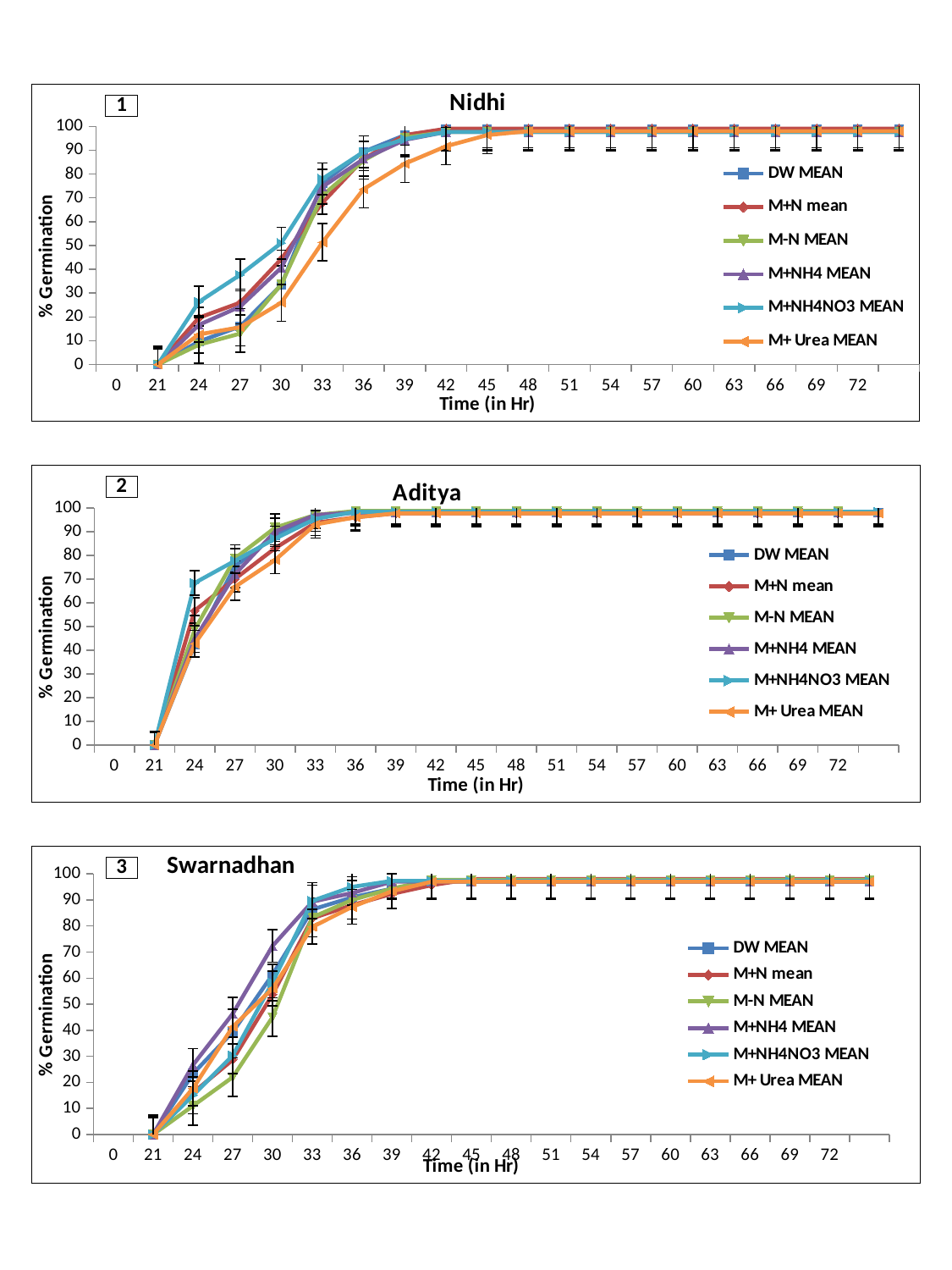
In the Swarnadhan chart, is the value for M-N MEAN at 27 hours greater or less than 30? less In the Nidhi chart, is the value for M+NH4NO3 MEAN at 30 hours greater or less than 40? greater In the Aditya chart, do the germination values rise or fall between 21 and 36 hours? rise In the Nidhi chart, is the value for M+ Urea MEAN at 33 hours greater or less than 60? less What is the title of the bottom chart? Swarnadhan What is the y-axis label on the Nidhi chart? % Germination What kind of chart is the Nidhi chart? line chart How many series does the legend of the Aditya chart list? 6 In the Nidhi chart, which is larger at 33 hours: M+NH4NO3 MEAN or M+ Urea MEAN? M+NH4NO3 MEAN